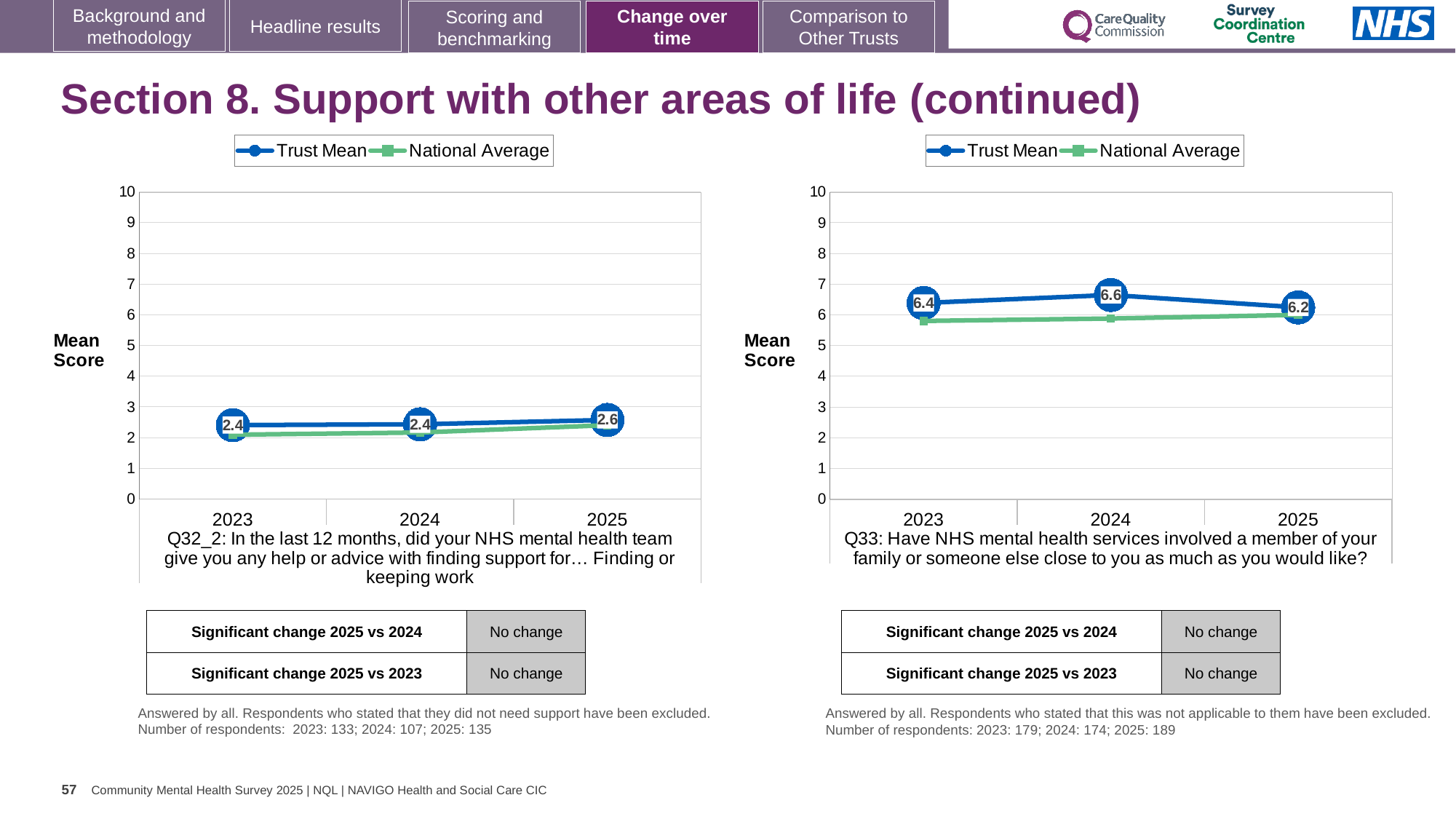
On the left chart (Q32_2), what is the Trust Mean for 2025? 2.6 How many series does the legend of the left chart list? 2 On the right chart (Q33), which year has the highest Trust Mean? 2024 On the right chart (Q33), is the National Average for 2024 greater or less than 5? greater On the right chart (Q33), what is the Trust Mean for 2024? 6.6 On the right chart (Q33), what is the difference between the Trust Mean in 2024 and in 2025? 0.4 On the left chart (Q32_2), what is the Trust Mean for 2023? 2.4 On the right chart (Q33), what is the Trust Mean for 2025? 6.2 On the right chart (Q33), which year has the lowest Trust Mean? 2025 On the left chart (Q32_2), is the National Average for 2023 greater or less than 3? less What kind of chart is the right chart (Q33)? Line chart On the left chart (Q32_2), what is the difference between the Trust Mean in 2025 and in 2023? 0.2